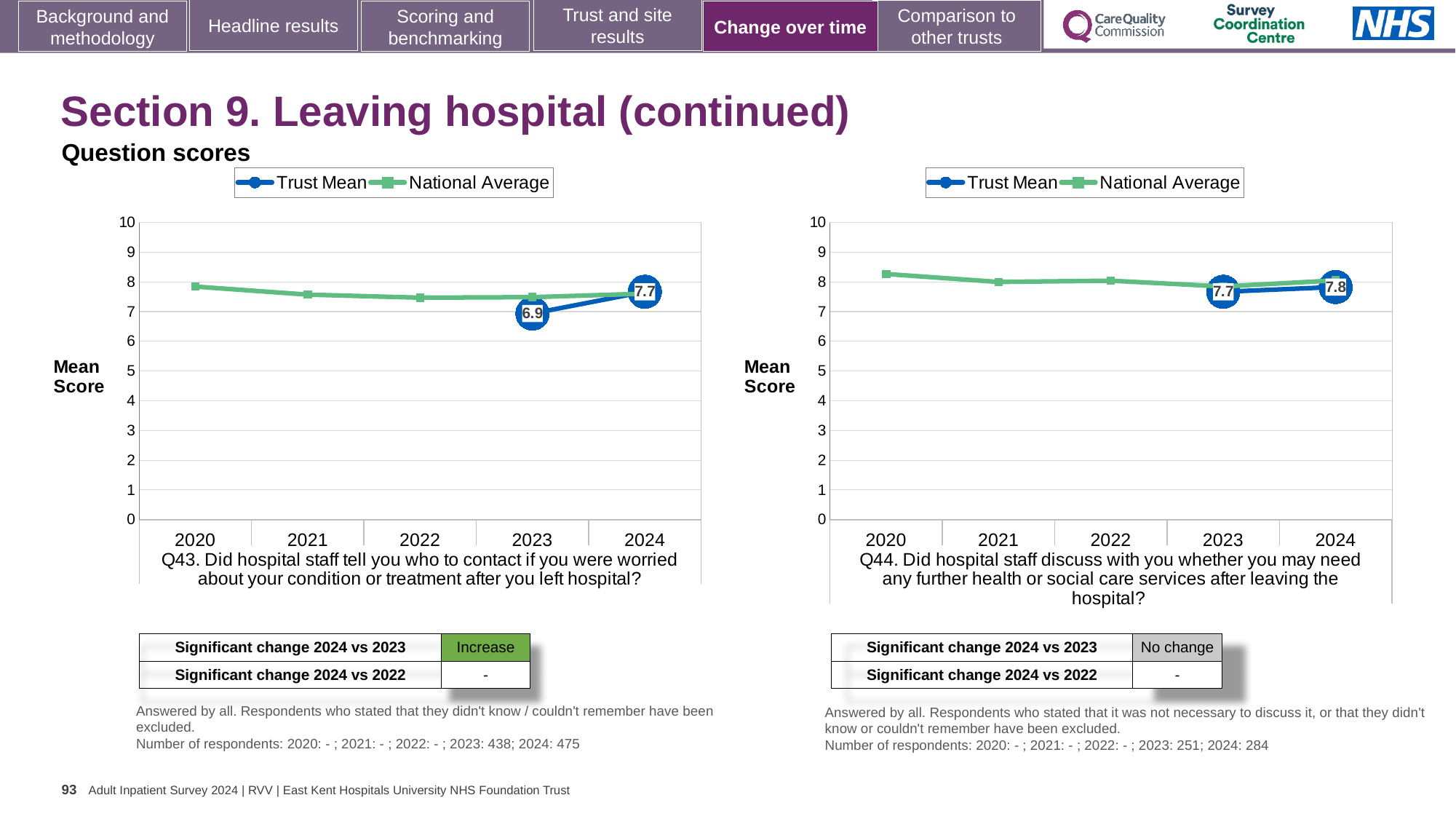
How many series does the legend of the Q43 chart on the left list? 2 In the Q43 chart on the left, is the National Average for 2020 greater or less than 7? greater In the Q44 chart on the right, what is the Trust Mean score for 2023? 7.7 What type of chart is used for the Q44 question scores on the right? line chart In the Q43 chart on the left, does the Trust Mean rise or fall from 2023 to 2024? rise In the Q43 chart on the left, by how much did the Trust Mean score change from 2023 to 2024? 0.8 How many years are shown on the x axis of the Q44 chart on the right? 5 In the Q43 chart on the left, what is the Trust Mean score for 2024? 7.7 In the Q43 chart on the left, what is the Trust Mean score for 2023? 6.9 In the Q44 chart on the right, what is the Trust Mean score for 2024? 7.8 In the Q43 chart on the left, which is higher in 2023: the Trust Mean or the National Average? National Average In the Q44 chart on the right, is the National Average for 2020 greater or less than 8? greater